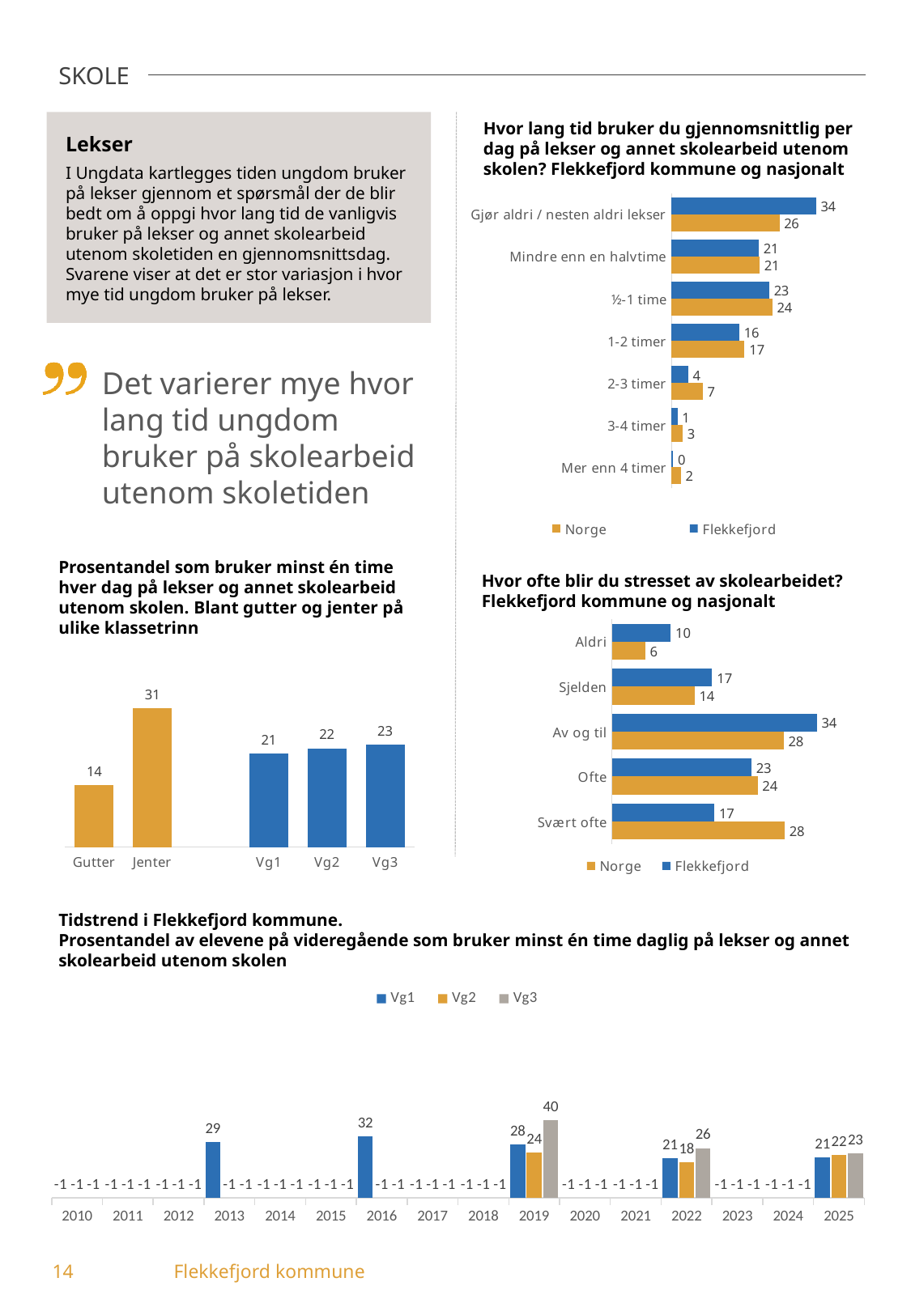
In the chart 'Hvor lang tid bruker du gjennomsnittlig per dag på lekser og annet skolearbeid utenom skolen?', what is the difference between the Flekkefjord and Norge values for 'Gjør aldri / nesten aldri lekser'? 8 In the chart 'Hvor ofte blir du stresset av skolearbeidet?', which category has the highest Flekkefjord value? Av og til What kind of chart is 'Tidstrend i Flekkefjord kommune'? Bar chart In the chart 'Prosentandel som bruker minst én time hver dag på lekser og annet skolearbeid utenom skolen', what is the value for Gutter? 14 In the chart 'Hvor ofte blir du stresset av skolearbeidet?', is the Flekkefjord value or the Norge value larger for 'Aldri'? Flekkefjord In the chart 'Prosentandel som bruker minst én time hver dag på lekser og annet skolearbeid utenom skolen', which category has the highest value? Jenter In the chart 'Tidstrend i Flekkefjord kommune', what is the Vg3 value for 2019? 40 In the chart 'Prosentandel som bruker minst én time hver dag på lekser og annet skolearbeid utenom skolen', how many categories are shown? 5 In the chart 'Hvor lang tid bruker du gjennomsnittlig per dag på lekser og annet skolearbeid utenom skolen?', what is the Norge value for '2-3 timer'? 7 In the chart 'Hvor ofte blir du stresset av skolearbeidet?', what is the Norge value for 'Svært ofte'? 28 In the chart 'Hvor lang tid bruker du gjennomsnittlig per dag på lekser og annet skolearbeid utenom skolen?', how many series does the legend list? 2 In the chart 'Hvor lang tid bruker du gjennomsnittlig per dag på lekser og annet skolearbeid utenom skolen?', what is the Flekkefjord value for 'Gjør aldri / nesten aldri lekser'? 34